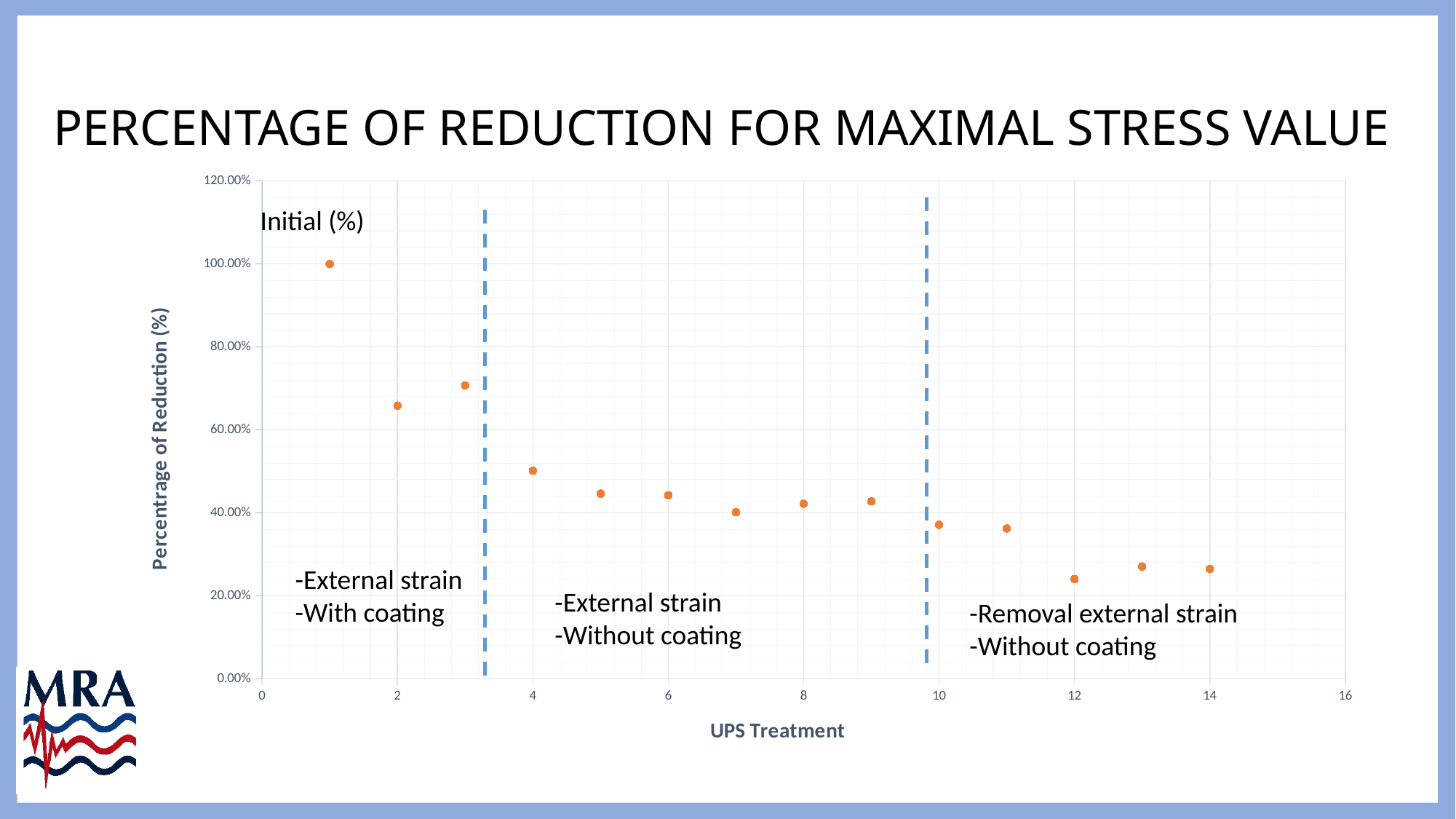
What is the title of the y axis? Percentage of Reduction (%) Is the value for UPS treatment 4 greater or less than 40.00%? greater At which UPS treatment is the percentage of reduction lowest? 12 What is the percentage of reduction at UPS treatment 1? 100.00% Which has a higher percentage of reduction, UPS treatment 2 or UPS treatment 3? UPS treatment 3 How many data points are plotted on the chart? 14 What kind of chart is shown on the slide? Scatter chart Is the value for UPS treatment 12 greater or less than 40.00%? less Is the value for UPS treatment 3 greater or less than 80.00%? less At which UPS treatment is the percentage of reduction highest? 1 What is the title of the x axis? UPS Treatment Do the percentage of reduction values generally rise or fall as the UPS treatment number increases? Fall